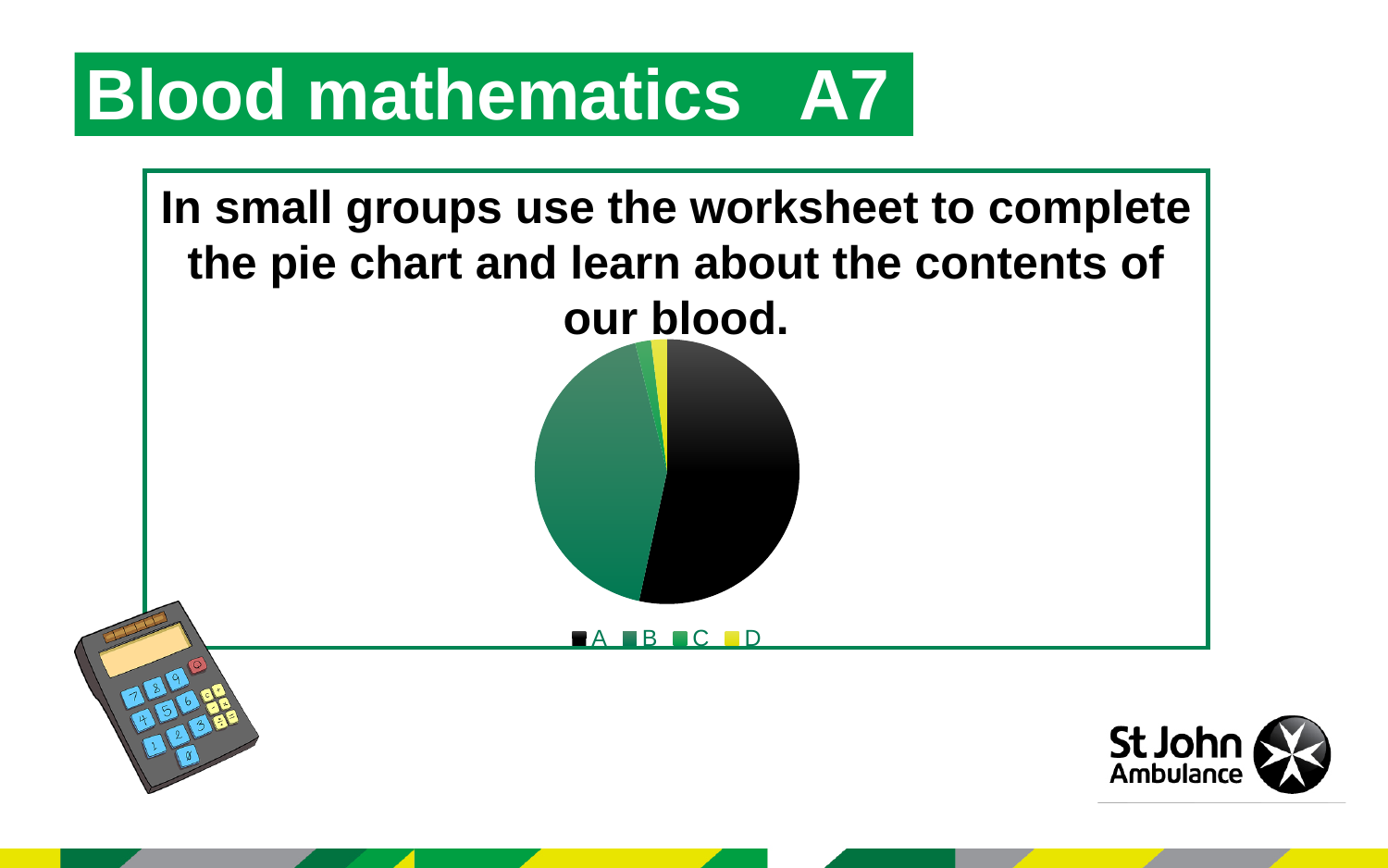
Which slice is larger in the pie chart, A or D? A What colour is the slice for category A in the pie chart? black Which slice is larger in the pie chart, B or D? B Which slice is larger in the pie chart, B or C? B How many categories does the pie chart's legend list? 4 Which category has the largest slice of the pie chart? A What kind of chart is shown on the slide? pie chart What colour is the slice for category D in the pie chart? yellow